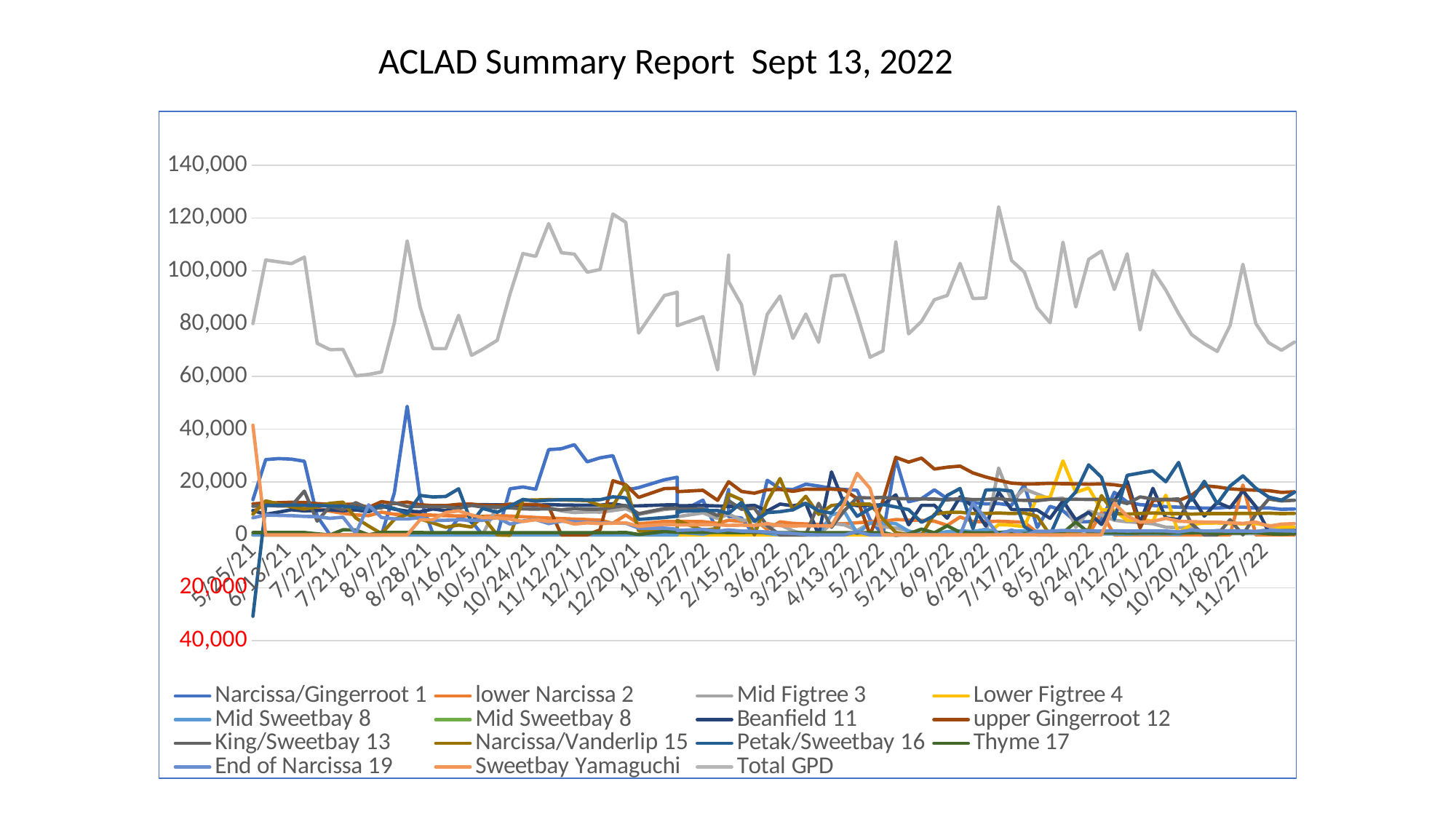
Around 8/28/21, which series is larger: Total GPD or Narcissa/Gingerroot 1? Total GPD Is the value of the Total GPD series at the first date (5/25/21) greater or less than 60,000? greater Is the lowest value of the Total GPD series greater or less than 40,000? greater What kind of chart is shown on the slide? line chart Which series has the highest values across the whole chart? Total GPD Is the peak value of the Total GPD series greater or less than 100,000? greater What is the highest value shown on the vertical axis? 140,000 How many series does the legend list? 15 Which legend entry appears twice in the legend? Mid Sweetbay 8